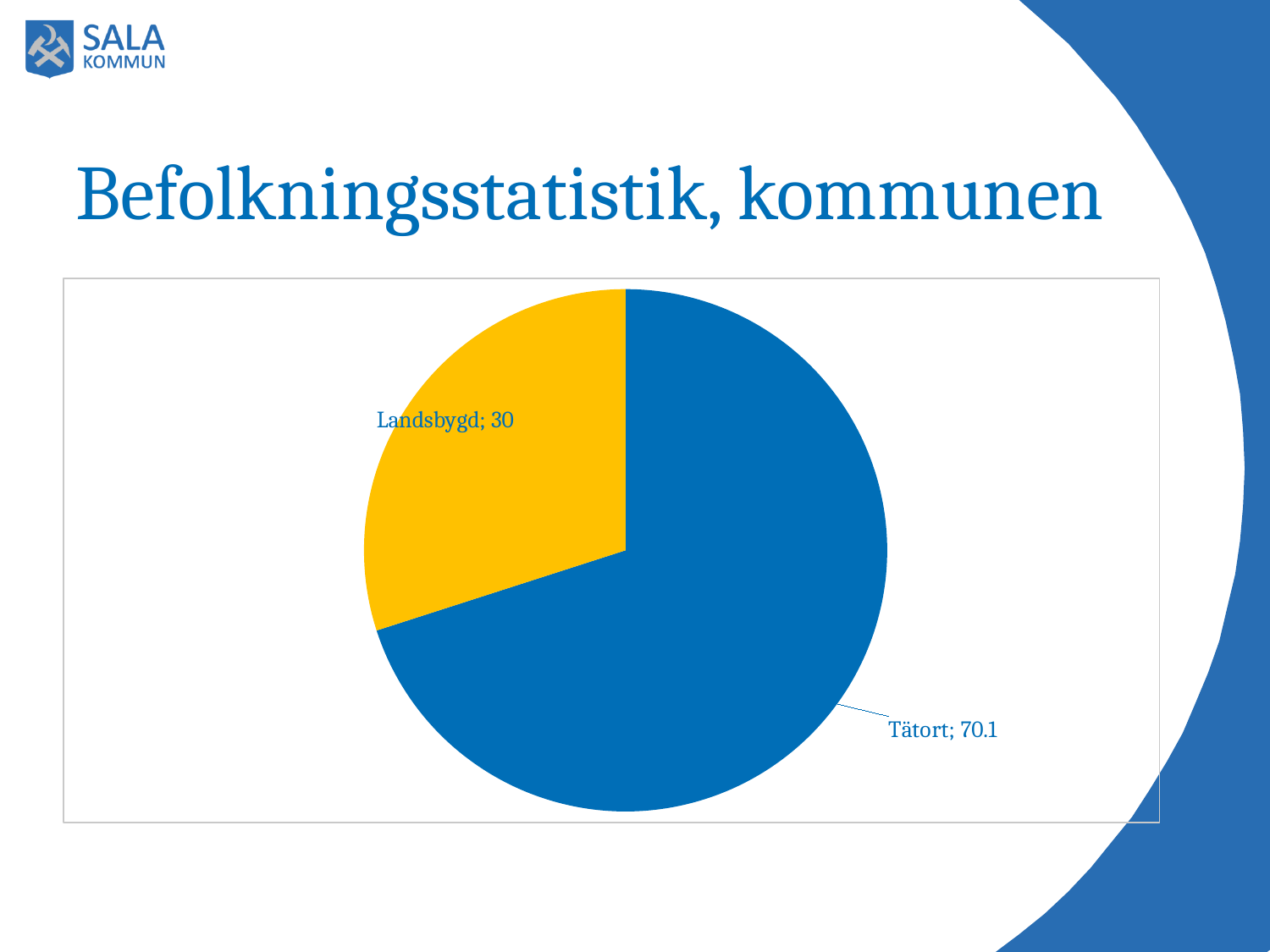
What value is shown for the Tätort slice of the pie chart? 70.1 Which slice of the pie chart has the smallest value? Landsbygd What is the difference between the Tätort value and the Landsbygd value in the pie chart? 40.1 What is the title of the slide containing the chart? Befolkningsstatistik, kommunen What value is shown for the Landsbygd slice of the pie chart? 30 Which slice of the pie chart has the largest value? Tätort How many slices does the pie chart have? 2 Which is larger in the pie chart, Tätort or Landsbygd? Tätort What colour is the Landsbygd slice of the pie chart? Yellow What kind of chart is shown on the slide? Pie chart